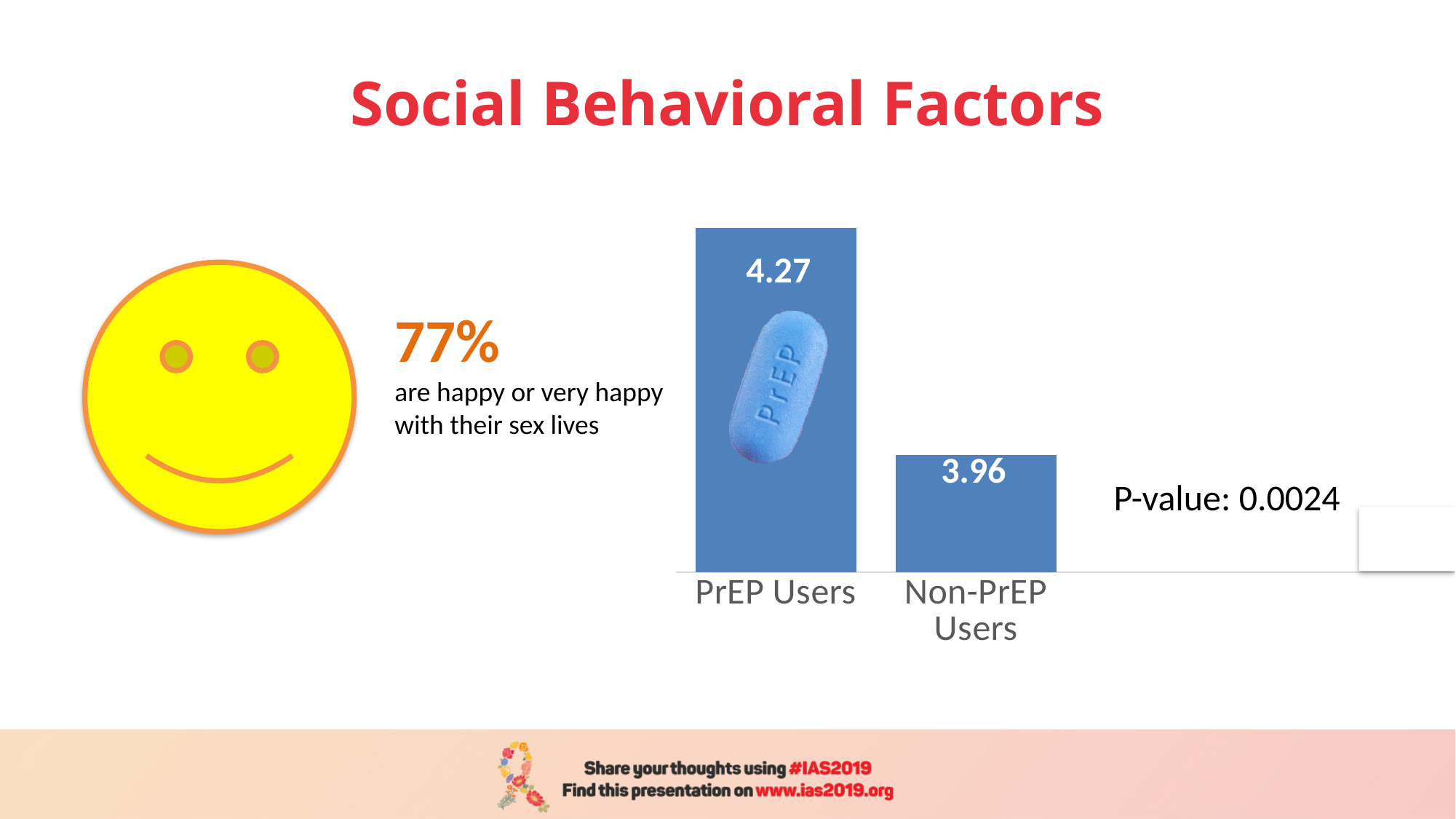
How many categories are shown in the chart? 2 What is the value for Non-PrEP Users? 3.96 What P-value is printed next to the chart? 0.0024 What is the value for PrEP Users? 4.27 What colour are the bars in the chart? Blue Do the values rise or fall from PrEP Users to Non-PrEP Users? Fall Which is larger, the value for PrEP Users or the value for Non-PrEP Users? PrEP Users What is the difference between the values for PrEP Users and Non-PrEP Users? 0.31 Which category has the lowest value? Non-PrEP Users What kind of chart is shown on the slide? Bar chart Which category has the highest value? PrEP Users